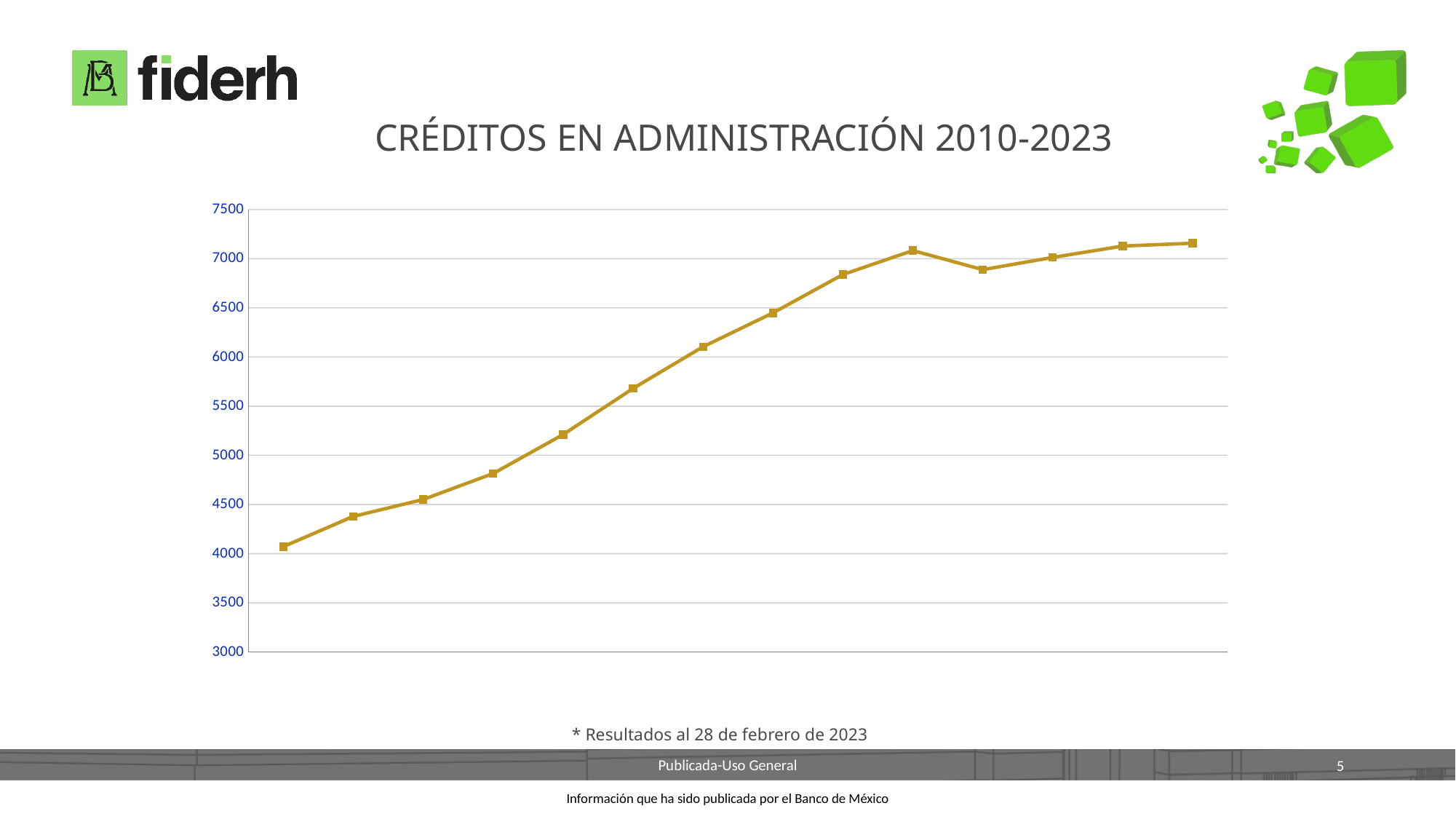
Is the value of the eleventh data point from the left greater or less than 7000? less Which is larger, the value of the first data point or the value of the last data point? the last data point Which data point has the lowest value, the first or the last? the first Do the values generally rise or fall from left to right along the x axis? rise What kind of chart is shown on the slide? line chart What is the highest value shown on the vertical axis? 7500 Is the value of the last (rightmost) data point greater or less than 7000? greater What is the title of the chart on the slide? CRÉDITOS EN ADMINISTRACIÓN 2010-2023 Is the value of the ninth data point from the left greater or less than 7000? less How many data points are plotted on the line? 14